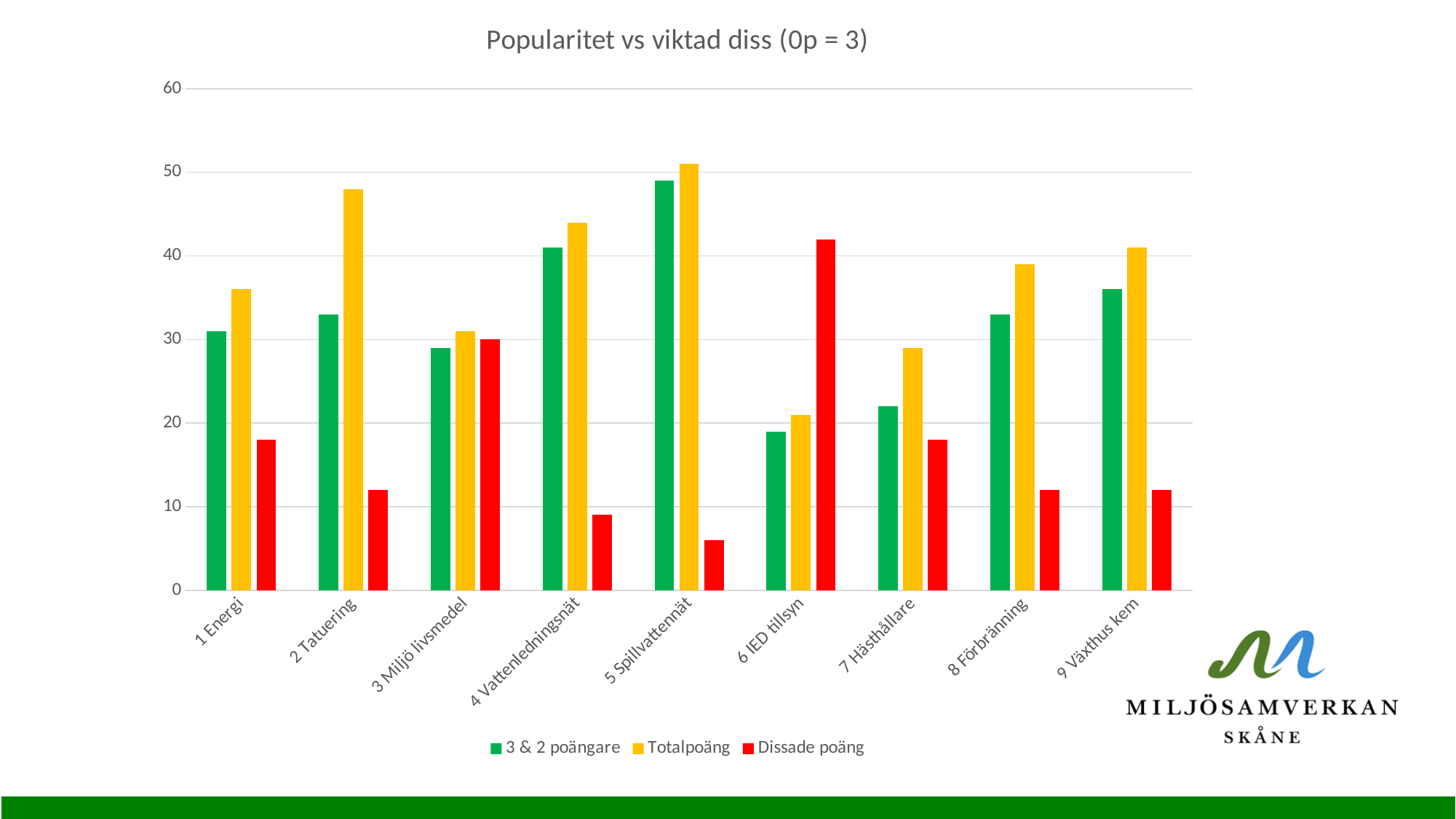
What kind of chart is shown on the slide? bar chart Is the Totalpoäng value for 2 Tatuering greater or less than 40? greater Which category has the lowest Dissade poäng value? 5 Spillvattennät Is the Dissade poäng value for 5 Spillvattennät greater or less than 10? less Which is larger, the Dissade poäng value for 1 Energi or for 2 Tatuering? 1 Energi How many categories are shown on the x axis? 9 Which category has the highest Dissade poäng value? 6 IED tillsyn Which category has the lowest 3 & 2 poängare value? 6 IED tillsyn Which colour represents the Dissade poäng series? red What is the title of the chart? Popularitet vs viktad diss (0p = 3) How many series does the legend list? 3 Which category has the highest Totalpoäng value? 5 Spillvattennät